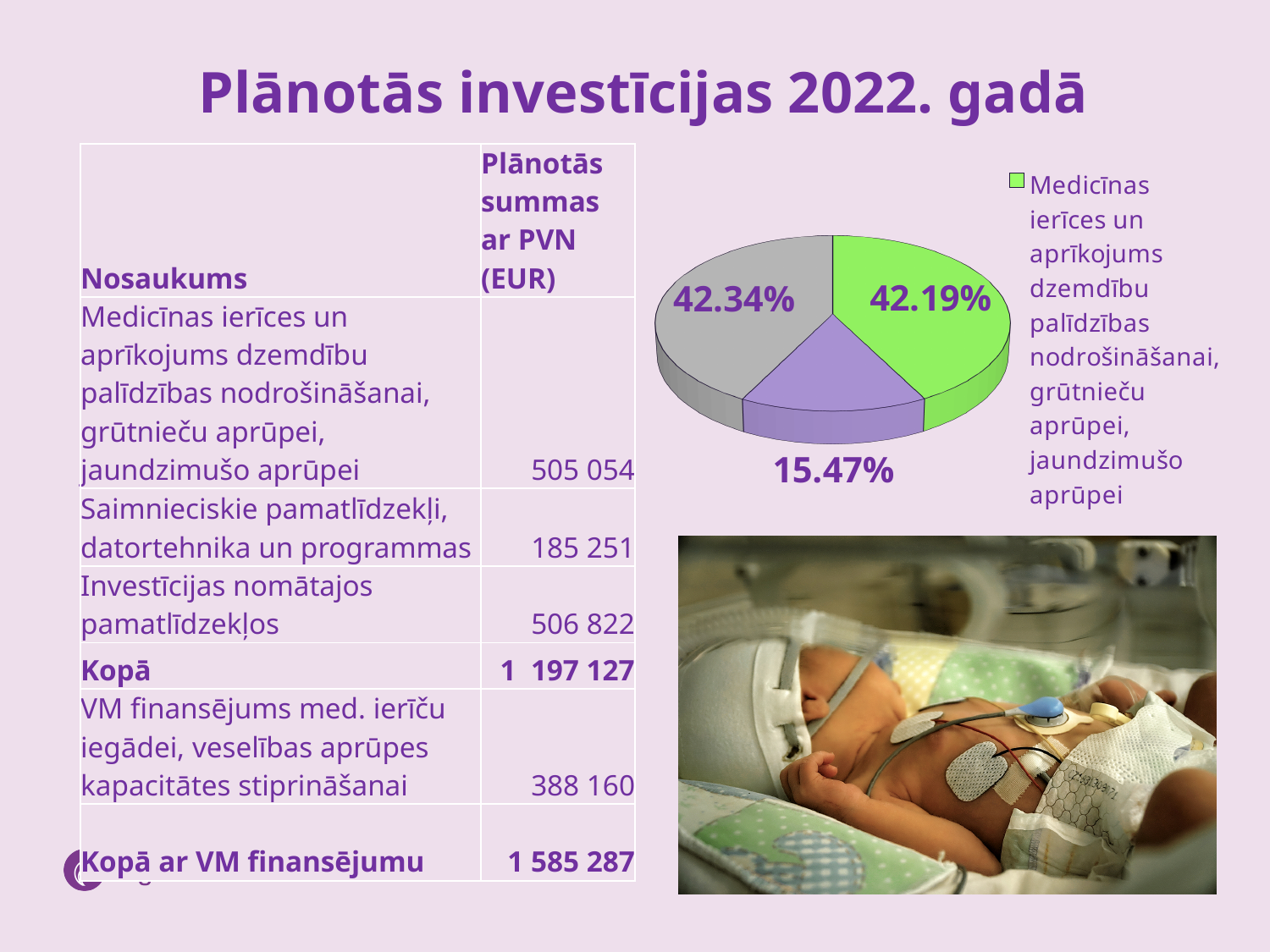
What colour is the pie slice for "Medicīnas ierīces un aprīkojums dzemdību palīdzības nodrošināšanai, grūtnieču aprūpei, jaundzimušo aprūpei"? Green What do the three percentages on the pie chart (42.19%, 15.47%, 42.34%) add up to? 100% What percentage is labelled on the purple slice of the pie chart? 15.47% What is the difference in percentage points between the green slice (42.19%) and the purple slice (15.47%) of the pie chart? 26.72 percentage points What percentage is labelled on the grey slice of the pie chart? 42.34% What is the largest percentage shown on the pie chart? 42.34% What percentage does the pie chart show for "Medicīnas ierīces un aprīkojums dzemdību palīdzības nodrošināšanai, grūtnieču aprūpei, jaundzimušo aprūpei"? 42.19% What is the smallest percentage shown on the pie chart? 15.47% Which slice of the pie chart is larger: the green slice or the purple slice? The green slice (42.19%) How many slices does the pie chart have? 3 What is the difference in percentage points between the grey slice (42.34%) and the green slice (42.19%) of the pie chart? 0.15 percentage points What type of chart is shown on the slide? Pie chart